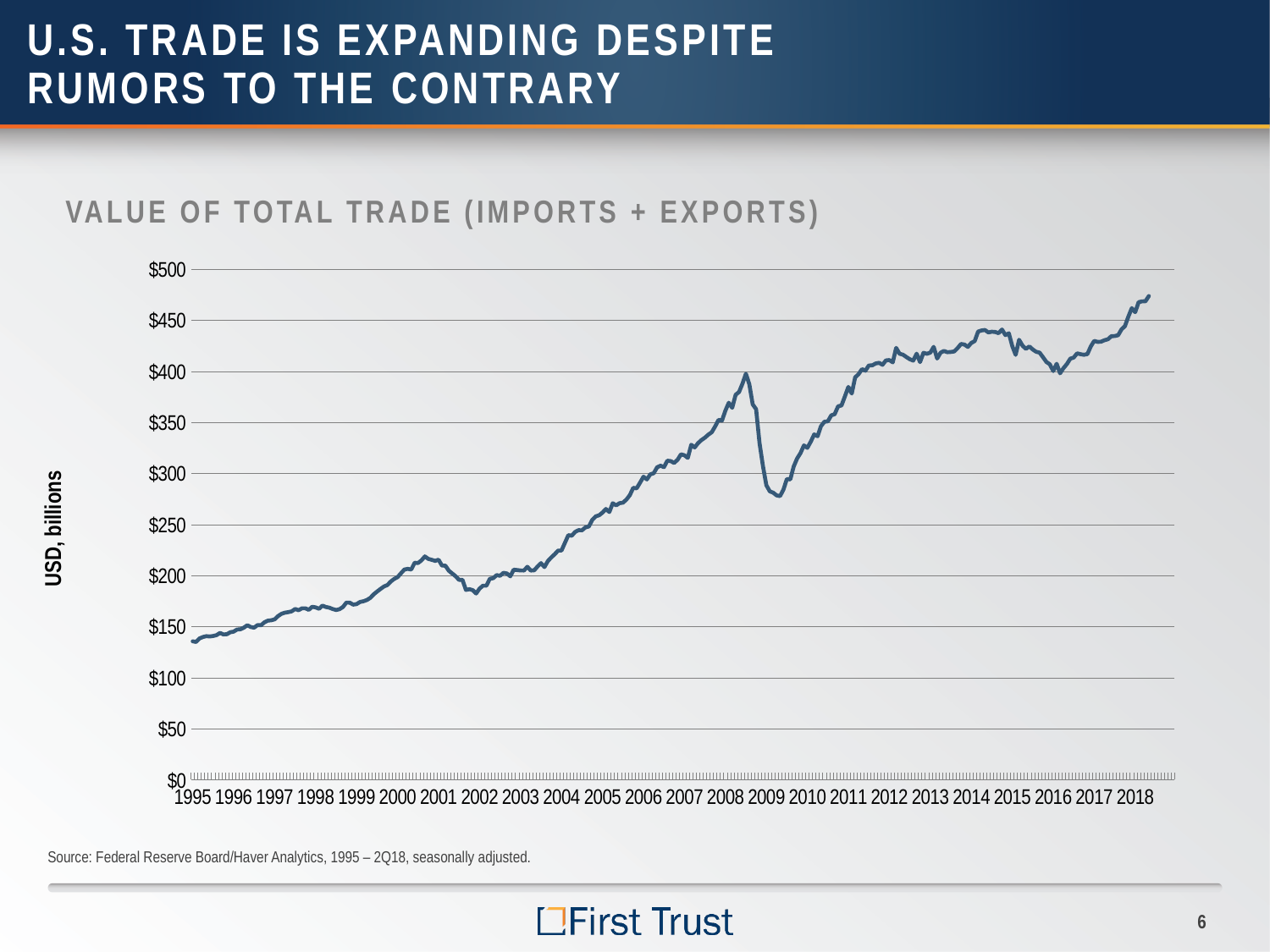
How many year labels are shown along the horizontal axis? 24 In which year does the line reach its highest value? 2018 In which year does the line have its lowest value? 1995 Is the value of total trade at the start of 1995 greater or less than $150? less Overall, does the value of total trade rise or fall from 1995 to 2018? rise Is the value of total trade at its peak in 2008 greater or less than $350? greater What is the title of the chart? Value of Total Trade (Imports + Exports) Is the value of total trade at its lowest point in 2009 greater or less than $300? less What is the label on the vertical axis of the chart? USD, billions What kind of chart is shown on the slide? line chart